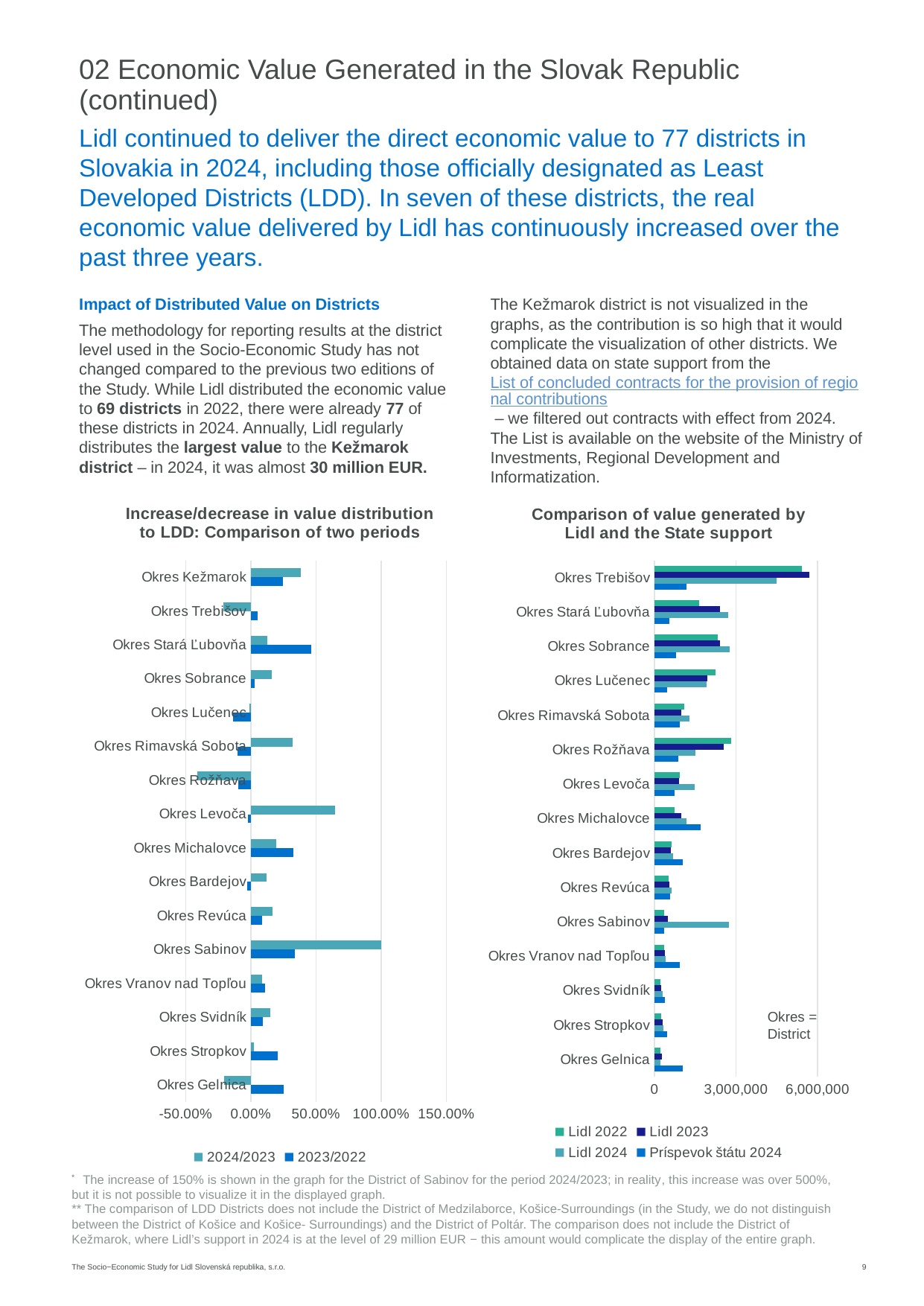
How many series does the legend of the left chart, 'Increase/decrease in value distribution to LDD', list? 2 What is the name of the fourth series in the legend of the right chart, 'Comparison of value generated by Lidl and the State support'? Príspevok štátu 2024 In the left chart, 'Increase/decrease in value distribution to LDD', is the 2024/2023 value for Okres Levoča greater or less than 50.00%? greater How many series does the legend of the right chart, 'Comparison of value generated by Lidl and the State support', list? 4 In the right chart, 'Comparison of value generated by Lidl and the State support', which district has the highest Lidl 2023 value? Okres Trebišov In the right chart, 'Comparison of value generated by Lidl and the State support', is the Lidl 2022 value for Okres Trebišov greater or less than 3,000,000? greater How many districts are shown in the left chart, 'Increase/decrease in value distribution to LDD'? 16 In the left chart, 'Increase/decrease in value distribution to LDD', which district has the highest 2024/2023 value? Okres Sabinov What kind of chart is the left chart, 'Increase/decrease in value distribution to LDD: Comparison of two periods'? Bar chart In the left chart, 'Increase/decrease in value distribution to LDD', which is larger for Okres Stará Ľubovňa: the 2024/2023 value or the 2023/2022 value? 2023/2022 In the left chart, 'Increase/decrease in value distribution to LDD', is the 2024/2023 value for Okres Gelnica greater or less than 0.00%? less How many districts are shown in the right chart, 'Comparison of value generated by Lidl and the State support'? 15